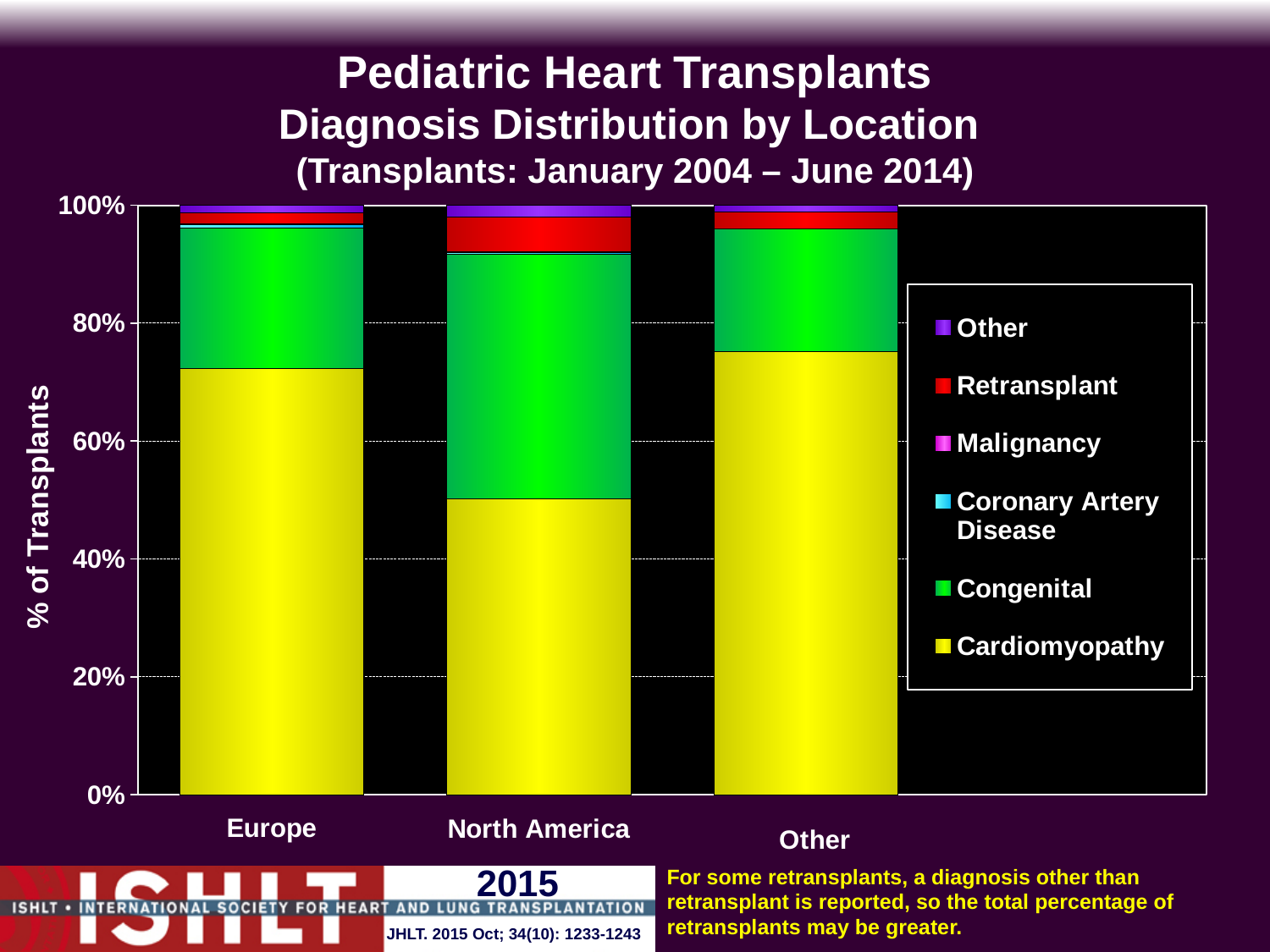
Which location has the lowest Cardiomyopathy share? North America Is the Cardiomyopathy share for North America greater or less than 60%? less Is the Cardiomyopathy share for Other greater or less than 60%? greater What kind of chart is shown on the slide? Stacked bar chart How many location categories are shown on the x axis? 3 Which location has the largest Retransplant share? North America How many series does the legend list? 6 Is the Cardiomyopathy share for Europe greater or less than 60%? greater Which is larger, the Cardiomyopathy share for Europe or for North America? Europe Which location has the highest Congenital share? North America What is the label on the y axis? % of Transplants Which legend entry is shown in yellow? Cardiomyopathy